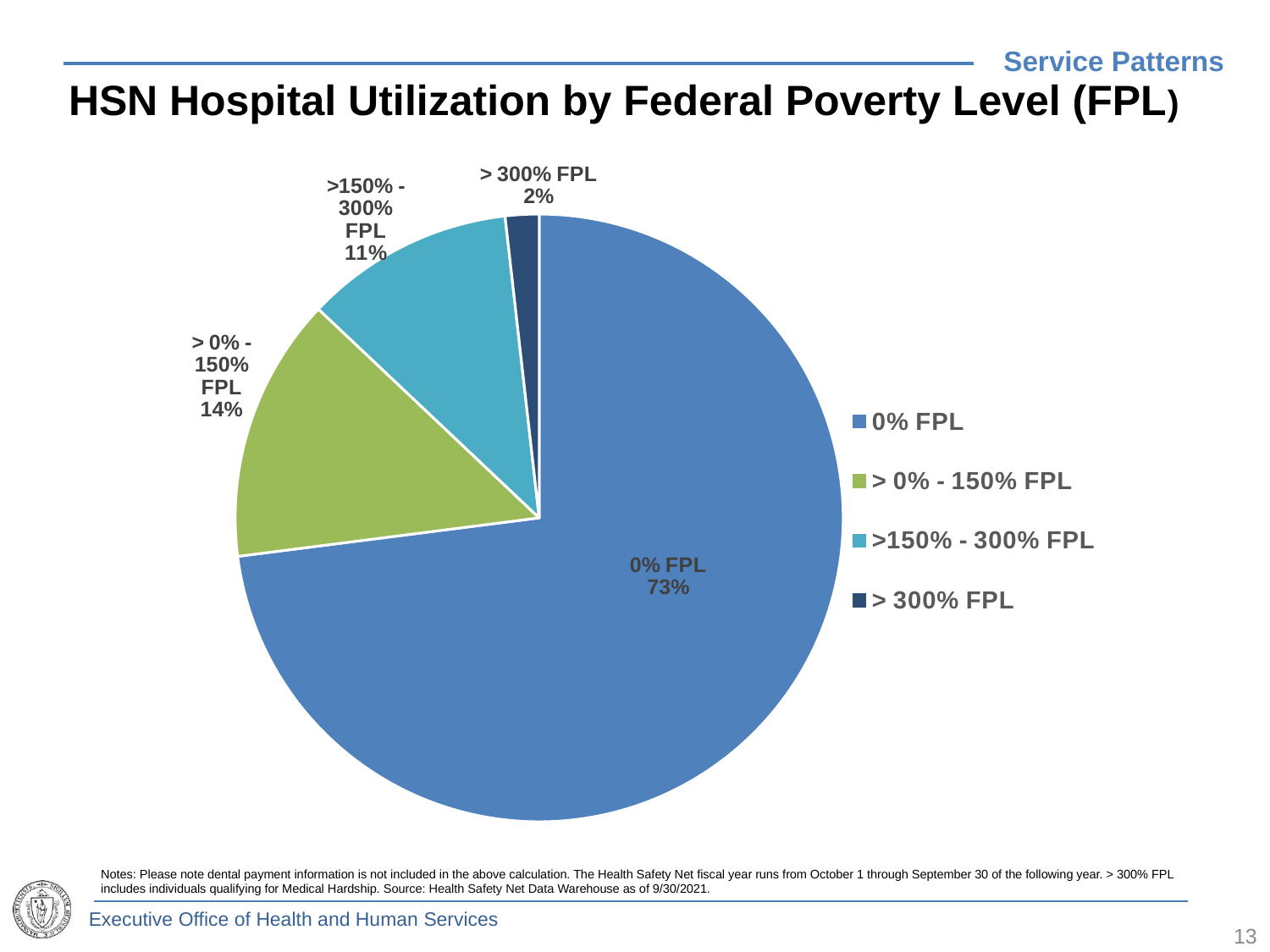
What is the title of the chart? HSN Hospital Utilization by Federal Poverty Level (FPL) What is the difference in percentage points between the >150% - 300% FPL share and the > 300% FPL share? 9 What share of HSN hospital utilization is for the > 0% - 150% FPL category? 14% What share of HSN hospital utilization is for the >150% - 300% FPL category? 11% Which FPL category has the smallest share of HSN hospital utilization? > 300% FPL What share of HSN hospital utilization is for the 0% FPL category? 73% How many FPL categories are shown in the pie chart? 4 Which has a larger share, > 0% - 150% FPL or >150% - 300% FPL? > 0% - 150% FPL What kind of chart is shown on the slide? Pie chart Which FPL category has the largest share of HSN hospital utilization? 0% FPL What is the difference in percentage points between the 0% FPL share and the > 0% - 150% FPL share? 59